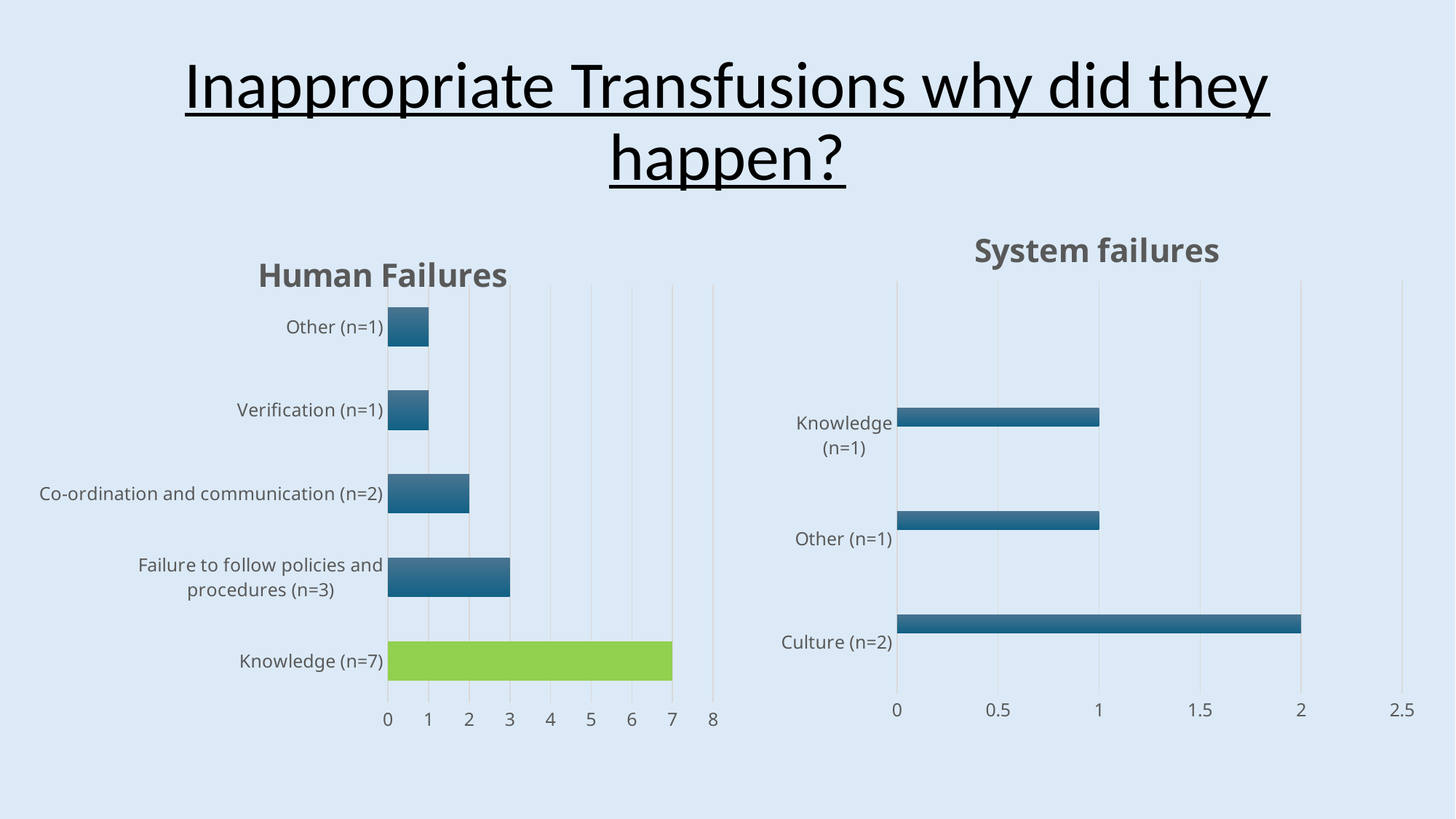
In the System failures chart, what is the difference between Culture and Knowledge? 1 In the System failures chart, which category has the highest value? Culture (n=2) In the Human Failures chart, which category has the highest value? Knowledge (n=7) In the Human Failures chart, what is the difference between Knowledge and Co-ordination and communication? 5 What type of chart is the Human Failures chart? Bar chart How many categories are shown in the Human Failures chart? 5 In the Human Failures chart, which is larger: Failure to follow policies and procedures or Verification? Failure to follow policies and procedures How many categories are shown in the System failures chart? 3 In the Human Failures chart, what is the value for Knowledge? 7 In the System failures chart, what is the value for Culture? 2 In the Human Failures chart, what is the value for Failure to follow policies and procedures? 3 In the Human Failures chart, which bar is coloured green rather than blue? Knowledge (n=7)